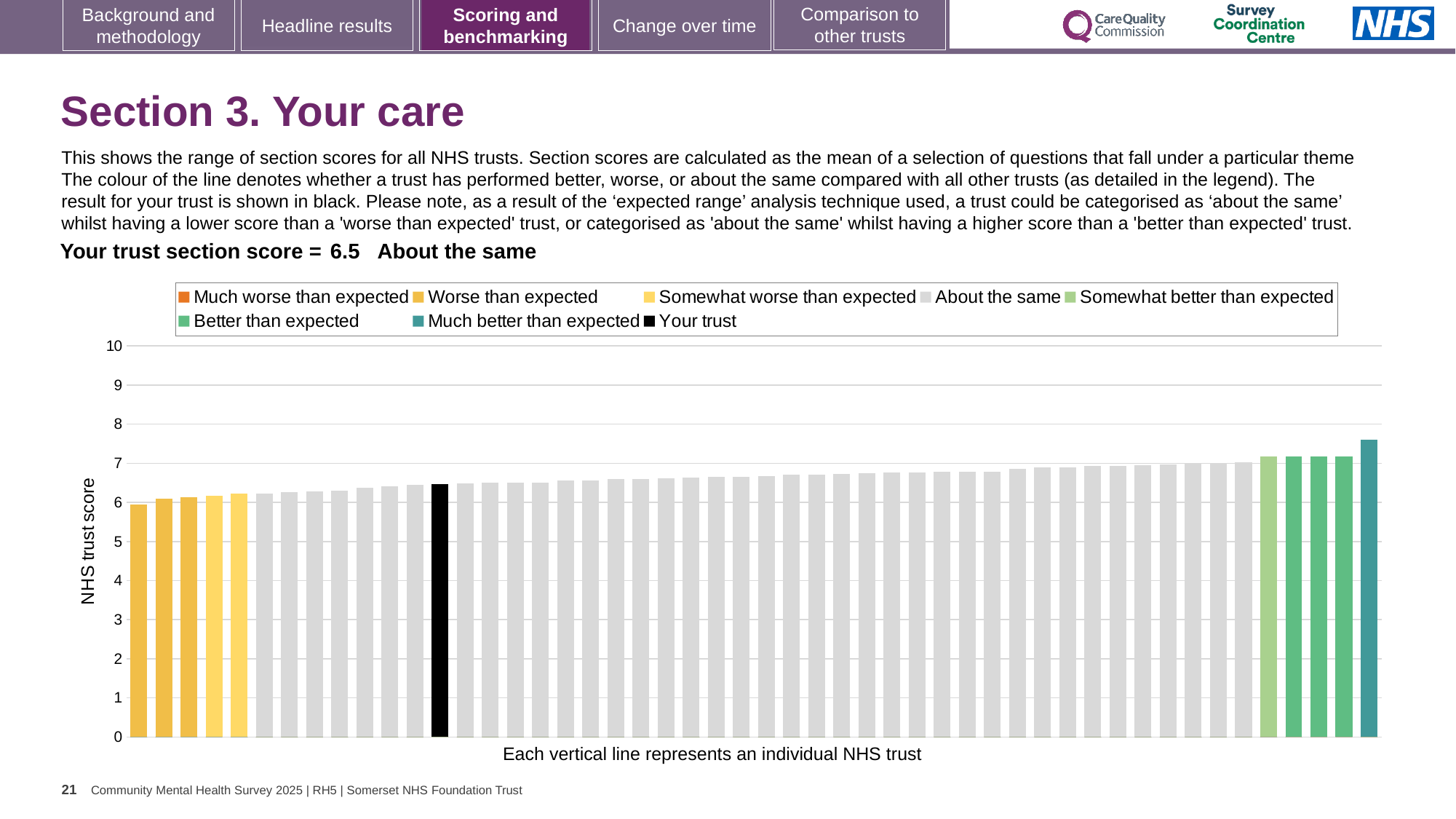
Is the value of the tallest bar (the rightmost, teal bar) greater or less than 7? greater According to the legend, what colour represents 'Your trust'? black What is the section score for your trust (the black bar)? 6.5 How many entries does the legend list? 8 What kind of chart is shown on the slide? bar chart Which bar is the highest: the rightmost teal bar or the black 'Your trust' bar? the rightmost teal bar What is the label on the vertical axis of the chart? NHS trust score What is the maximum value shown on the vertical axis? 10 Do the bar values rise or fall from left to right along the x axis? rise How is your trust categorised compared with other trusts in this section? About the same Is the value for your trust (the black bar) greater or less than 6? greater